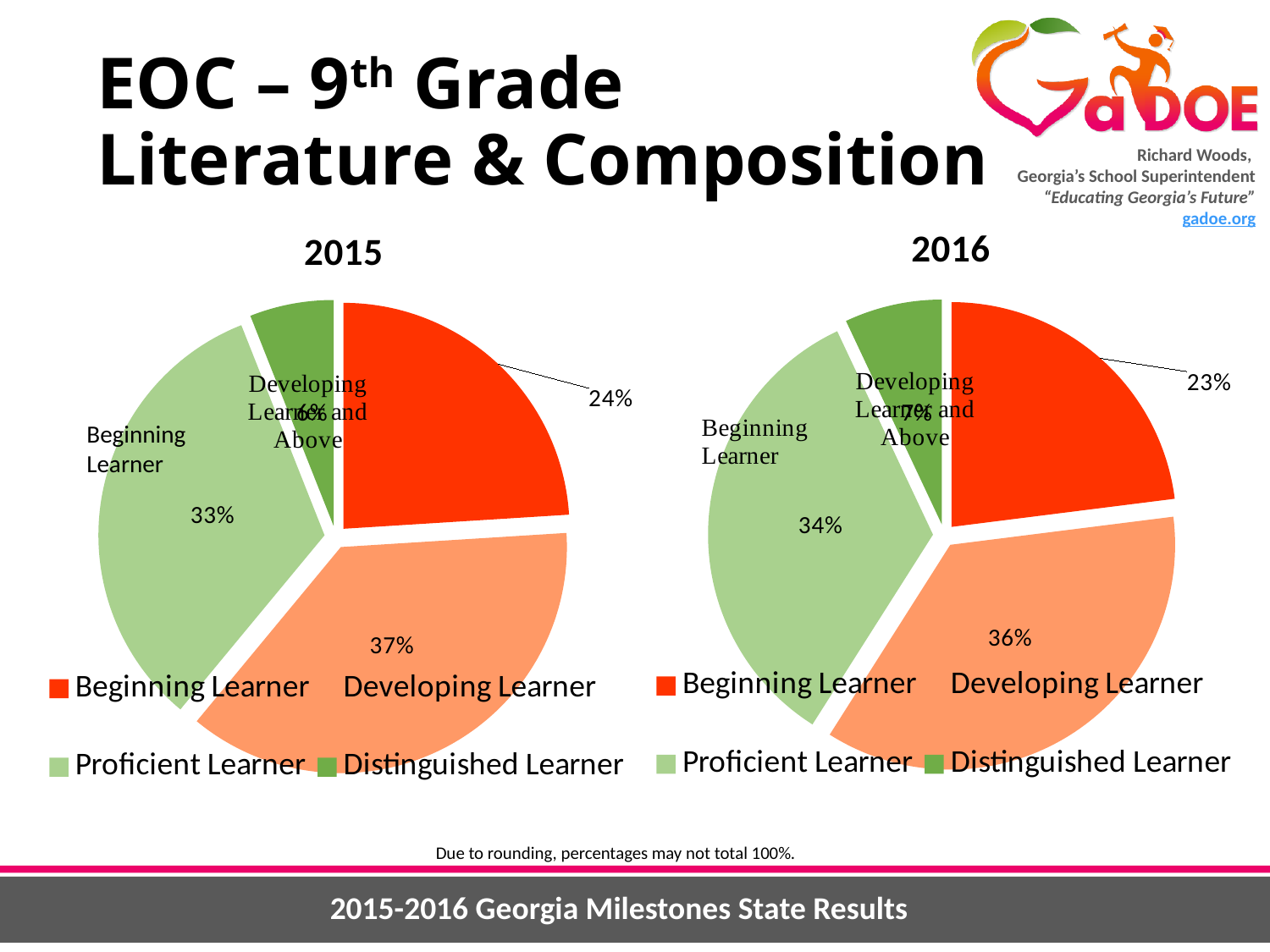
What type of chart is used to show the 2015 results? Pie chart In the 2016 pie chart, which category has the largest share? Developing Learner Which is larger: the Proficient Learner share in 2015 or in 2016? 2016 In the 2016 pie chart, what is the combined share of Beginning Learner and Developing Learner? 59% In the 2016 pie chart, what percentage is shown for Proficient Learner? 34% How many categories does the legend of the 2016 pie chart list? 4 In the 2015 pie chart, what percentage is shown for Beginning Learner? 24% In the 2015 pie chart, which category has the smallest share? Distinguished Learner What is the difference between the Developing Learner share in 2015 and in 2016? 1% What colour represents Distinguished Learner in the legends of both charts? Dark green In the 2016 pie chart, what percentage is shown for Beginning Learner? 23% In the 2015 pie chart, what percentage is shown for Developing Learner? 37%